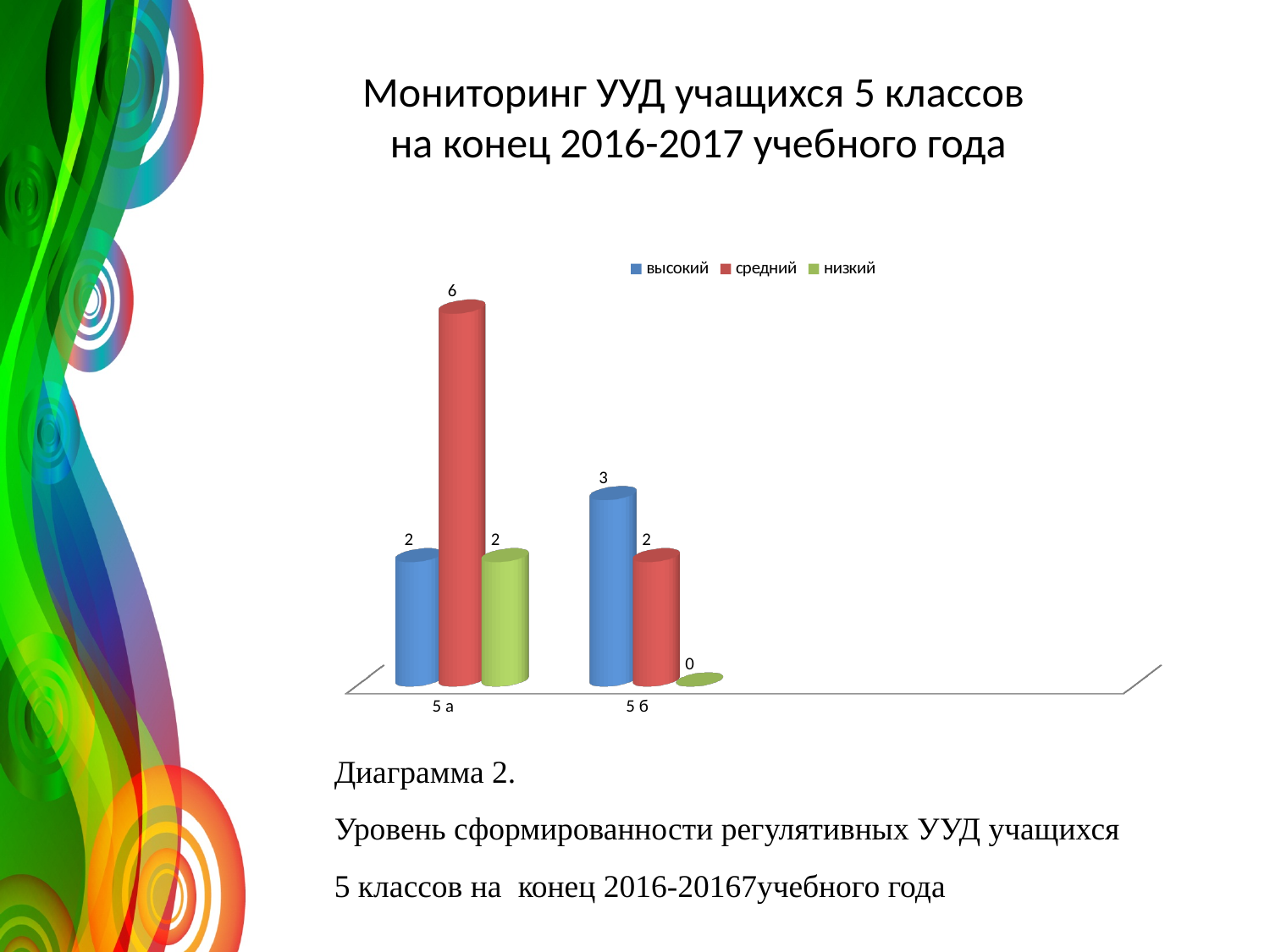
Which is larger: высокий in 5 а or высокий in 5 б? высокий in 5 б Which series has the highest value in class 5 а? средний What is the difference between средний in 5 а and средний in 5 б? 4 What is the value for средний in class 5 а? 6 What is the value for низкий in class 5 б? 0 Which series has the lowest value in class 5 б? низкий What kind of chart is shown on the slide? bar chart What colour represents the series средний in the chart? red How many series does the legend list? 3 How many classes (categories) are shown on the x axis? 2 What is the value for высокий in class 5 б? 3 What is the value for низкий in class 5 а? 2